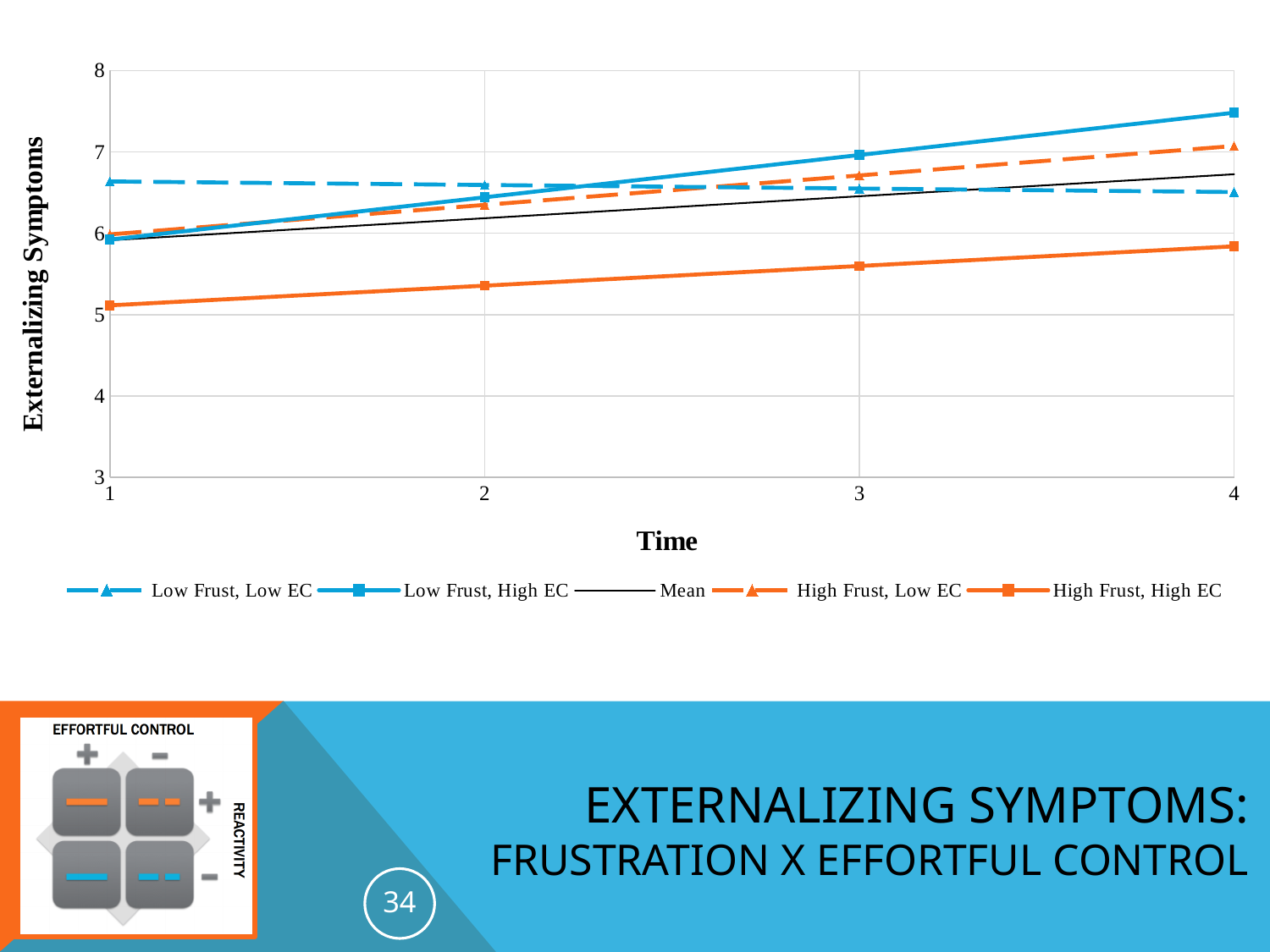
What kind of chart is shown on the slide? line chart Is the value for High Frust, High EC at time 4 greater or less than 6? less Which series has the highest value at time 4? Low Frust, High EC Do the values for High Frust, High EC rise or fall from time 1 to time 4? rise What is the label on the y axis? Externalizing Symptoms Is the value for Low Frust, High EC at time 4 greater or less than 7? greater How many series does the legend list? 5 Which series has the lowest value at time 4? High Frust, High EC Which series has the lowest value at time 1? High Frust, High EC How many time points are plotted along the x axis? 4 At time 4, which is larger: Low Frust, High EC or High Frust, Low EC? Low Frust, High EC Is the value for Low Frust, Low EC at time 1 greater or less than 6? greater